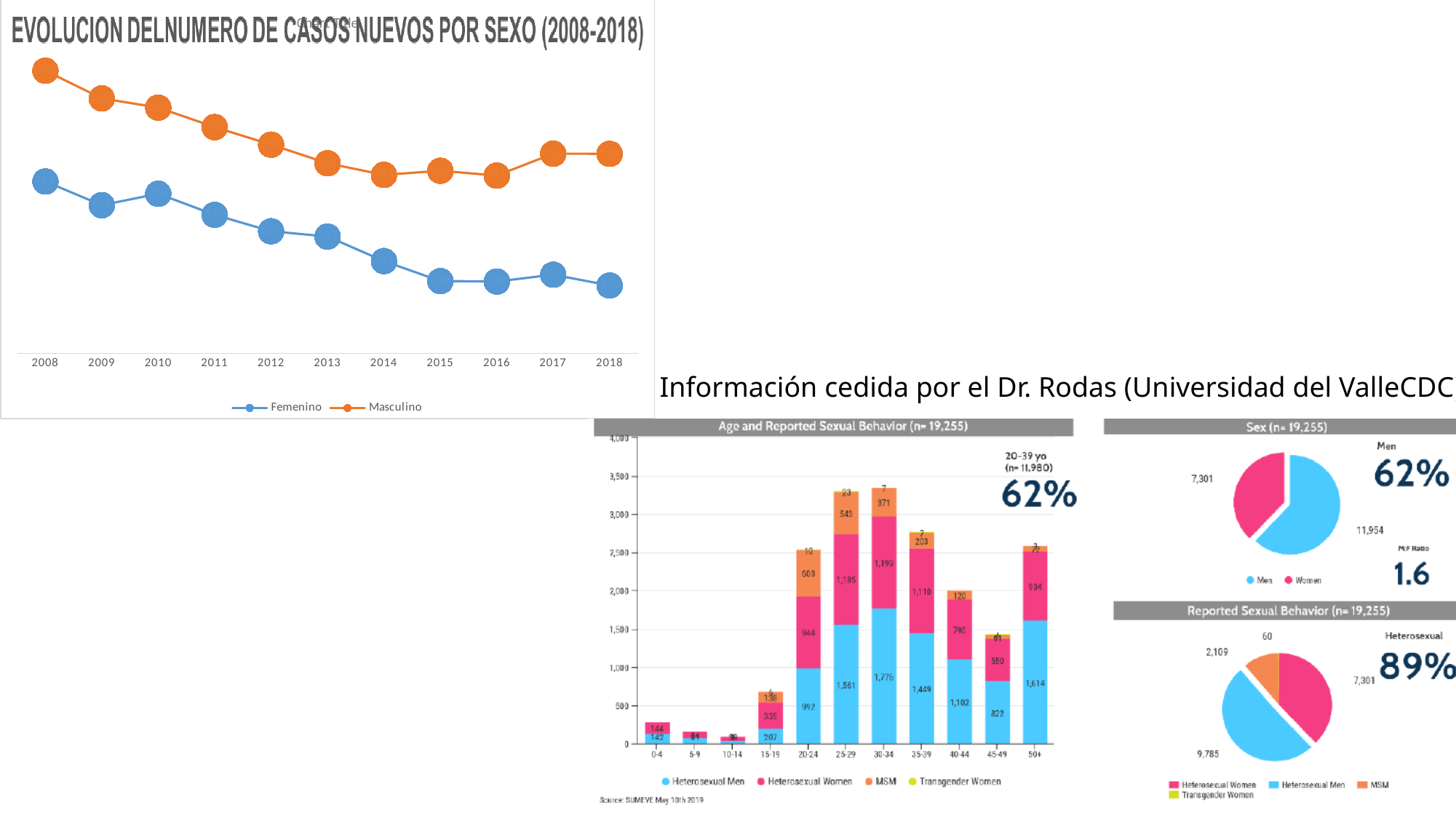
In the chart 'Age and Reported Sexual Behavior (n=19,255)', what is the difference between Heterosexual Men in the 25-29 group (1,561) and in the 20-24 group (992)? 569 In the chart 'EVOLUCION DEL NUMERO DE CASOS NUEVOS POR SEXO (2008-2018)', what kind of chart is it? Line chart In the chart 'Age and Reported Sexual Behavior (n=19,255)', what is the value for Heterosexual Men in the 30-34 age group? 1,776 In the pie chart 'Sex (n=19,255)', what percentage of the total is Men? 62% In the chart 'EVOLUCION DEL NUMERO DE CASOS NUEVOS POR SEXO (2008-2018)', which series is higher in 2012, Femenino or Masculino? Masculino In the chart 'Age and Reported Sexual Behavior (n=19,255)', how many age groups are shown on the x axis? 11 In the chart 'EVOLUCION DEL NUMERO DE CASOS NUEVOS POR SEXO (2008-2018)', how many series does the legend list? 2 In the pie chart 'Reported Sexual Behavior (n=19,255)', what is the value for MSM? 2,109 In the chart 'Age and Reported Sexual Behavior (n=19,255)', what is the value for Heterosexual Women in the 50+ age group? 904 In the chart 'EVOLUCION DEL NUMERO DE CASOS NUEVOS POR SEXO (2008-2018)', in which year is the Masculino series highest? 2008 In the chart 'EVOLUCION DEL NUMERO DE CASOS NUEVOS POR SEXO (2008-2018)', how many years are plotted on the x axis? 11 In the chart 'EVOLUCION DEL NUMERO DE CASOS NUEVOS POR SEXO (2008-2018)', does the Femenino series generally rise or fall from 2008 to 2018? Fall